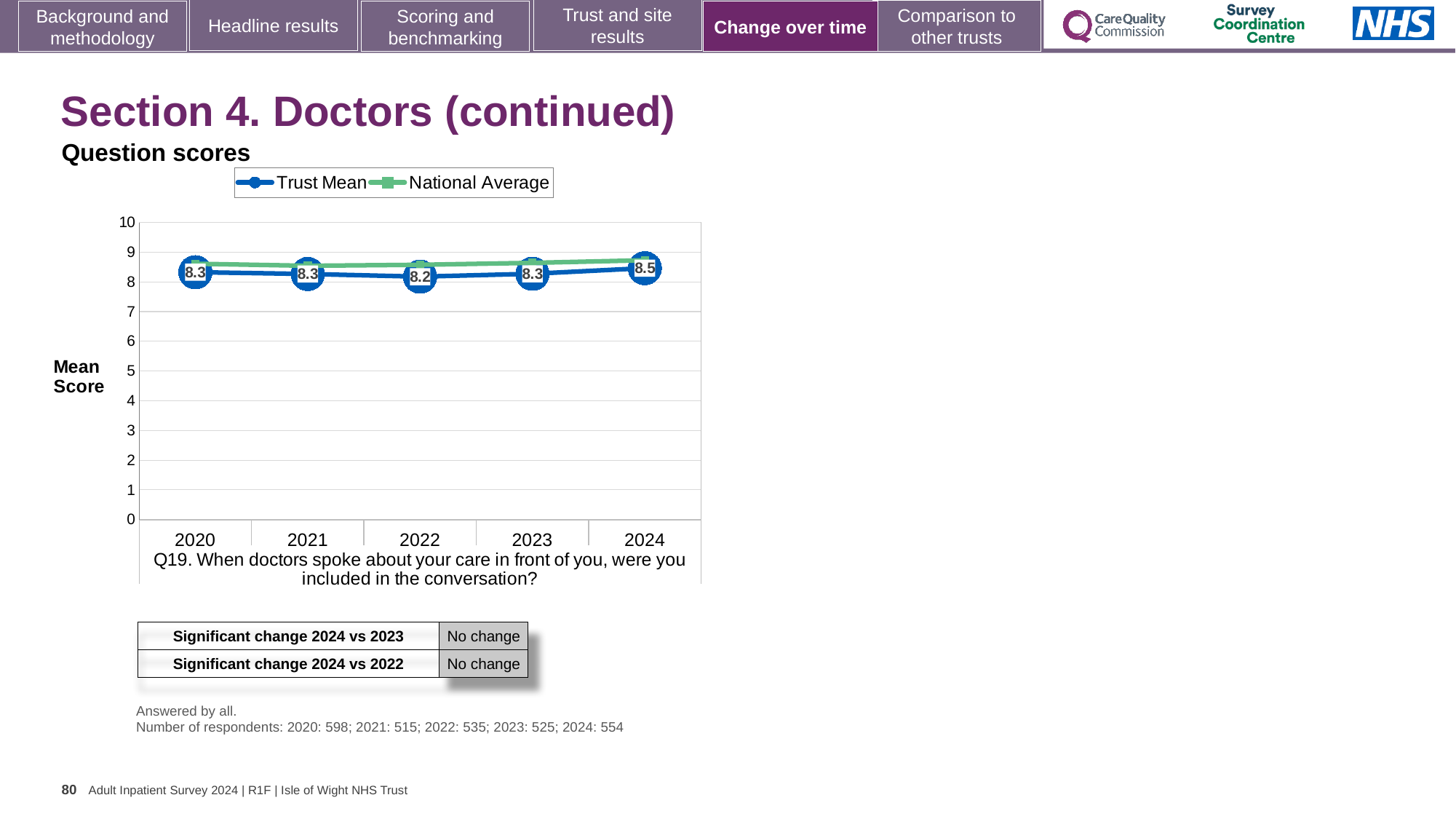
How many series does the legend list? 2 What is the Trust Mean score for 2020? 8.3 Is the National Average value for 2024 greater or less than 8? greater What is the Trust Mean score for 2024? 8.5 Does the Trust Mean rise or fall from 2022 to 2024? Rise In which year is the Trust Mean lowest? 2022 How many years are plotted on the x axis? 5 Which is larger, the Trust Mean in 2024 or the Trust Mean in 2023? 2024 What is the difference between the Trust Mean in 2024 and in 2022? 0.3 In which year is the Trust Mean highest? 2024 What kind of chart is shown? Line chart What is the Trust Mean score for 2022? 8.2